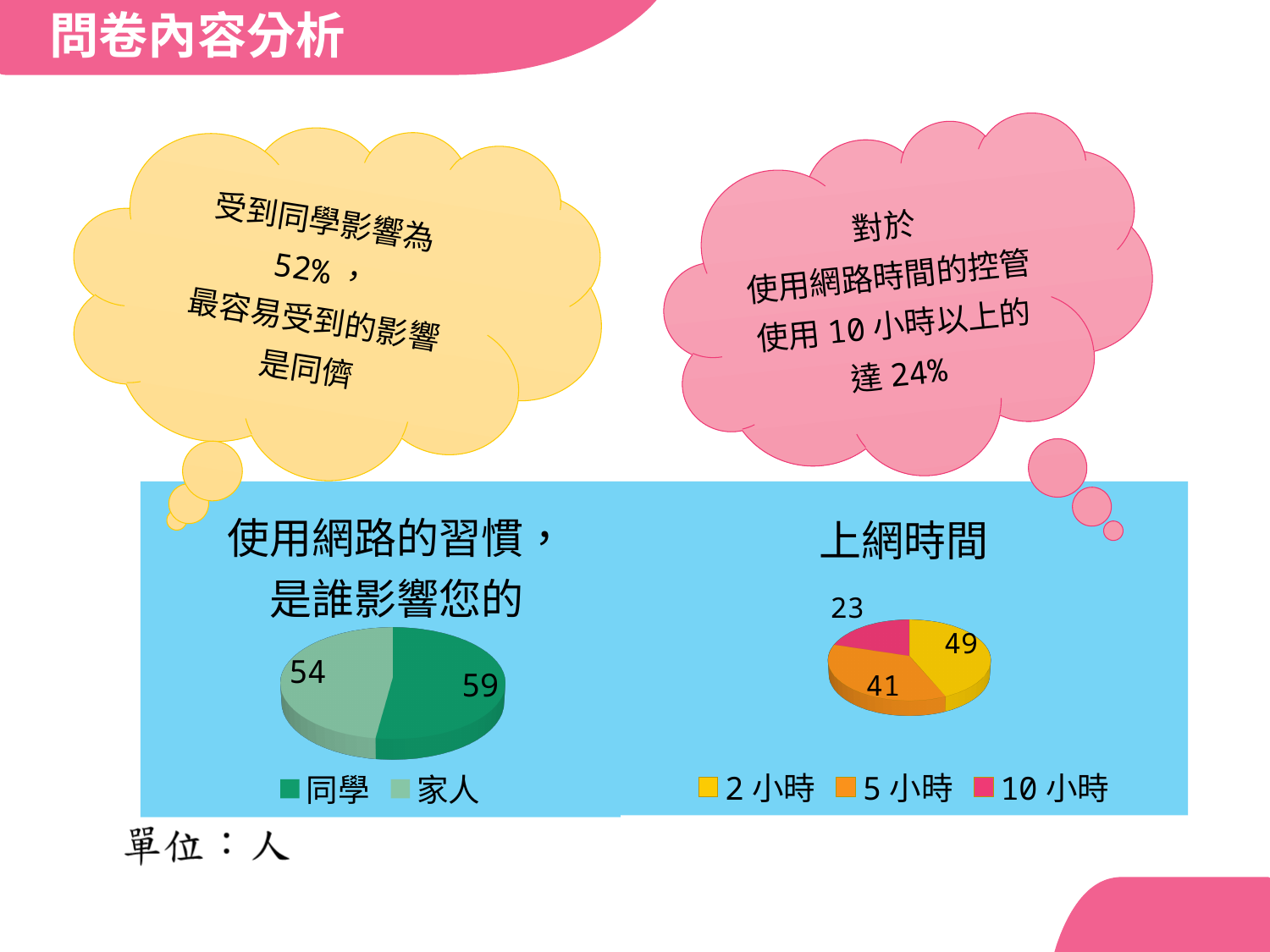
In the pie chart titled 上網時間, what colour is the 10 小時 slice? Pink In the pie chart titled 上網時間, what is the difference between the values for 2 小時 and 10 小時? 26 In the pie chart titled 使用網路的習慣，是誰影響您的, what is the value for 同學? 59 How many categories does the pie chart titled 上網時間 show? 3 In the pie chart titled 使用網路的習慣，是誰影響您的, what is the value for 家人? 54 In the pie chart titled 上網時間, which is larger, the value for 5 小時 or the value for 10 小時? 5 小時 In the pie chart titled 上網時間, which category has the largest value? 2 小時 In the pie chart titled 使用網路的習慣，是誰影響您的, what is the difference between the values for 同學 and 家人? 5 In the pie chart titled 上網時間, what is the value for 10 小時? 23 What kind of chart is the chart titled 使用網路的習慣，是誰影響您的? Pie chart In the pie chart titled 上網時間, what is the value for 2 小時? 49 In the pie chart titled 上網時間, which category has the smallest value? 10 小時